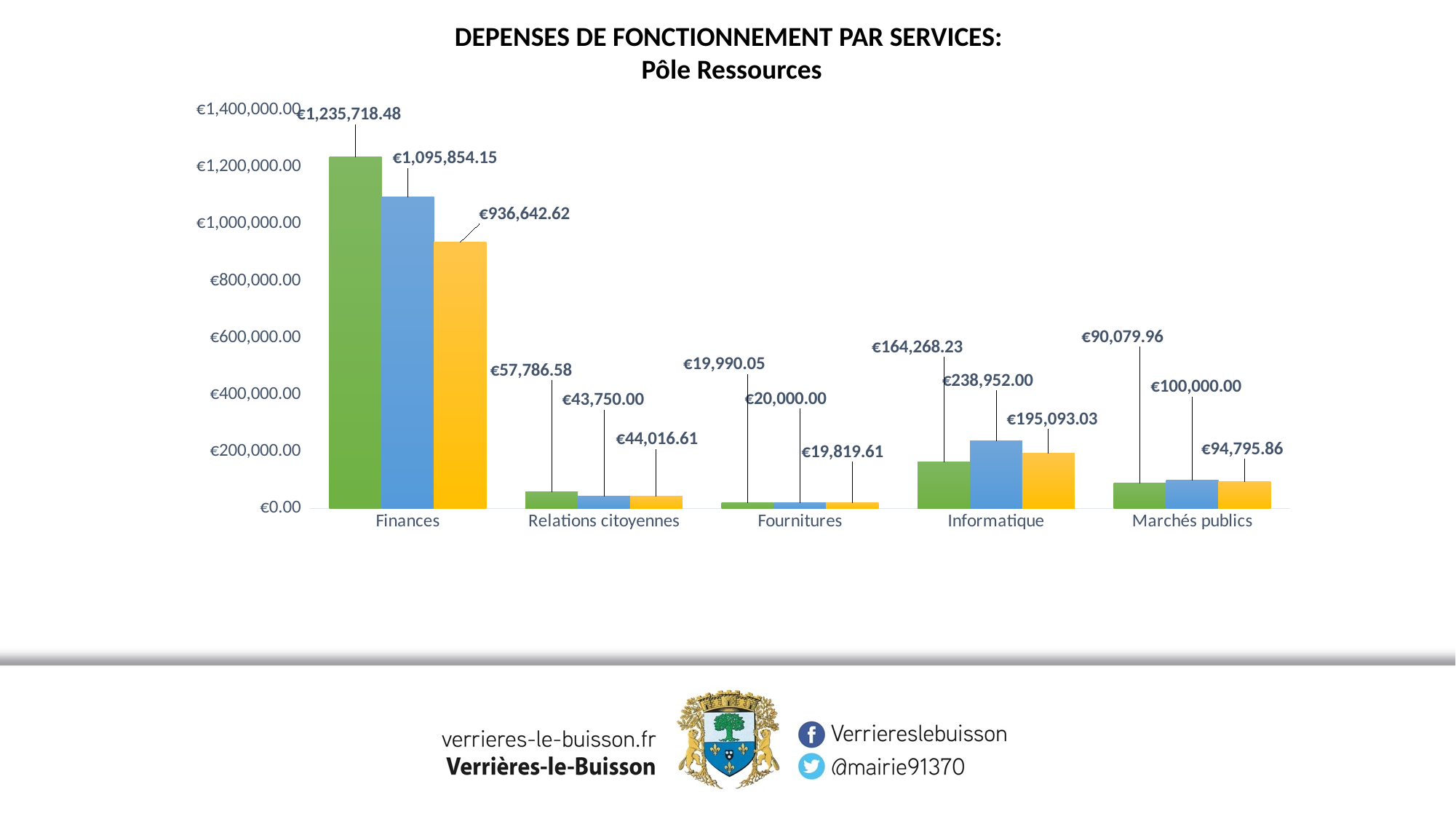
Is the value of the orange bar for Finances greater or less than €800,000.00? greater Which is larger for Informatique, the green bar or the blue bar? the blue bar Which category has the lowest orange bar? Fournitures Which category has the highest green bar? Finances What is the value of the orange bar for Relations citoyennes? €44,016.61 How many categories are shown on the x axis? 5 What is the difference between the green and blue bars for Finances? €139,864.33 What is the value of the green bar for Finances? €1,235,718.48 What is the value of the blue bar for Informatique? €238,952.00 What kind of chart is shown on the slide? bar chart What is the difference between the blue and orange bars for Informatique? €43,858.97 What is the value of the blue bar for Marchés publics? €100,000.00